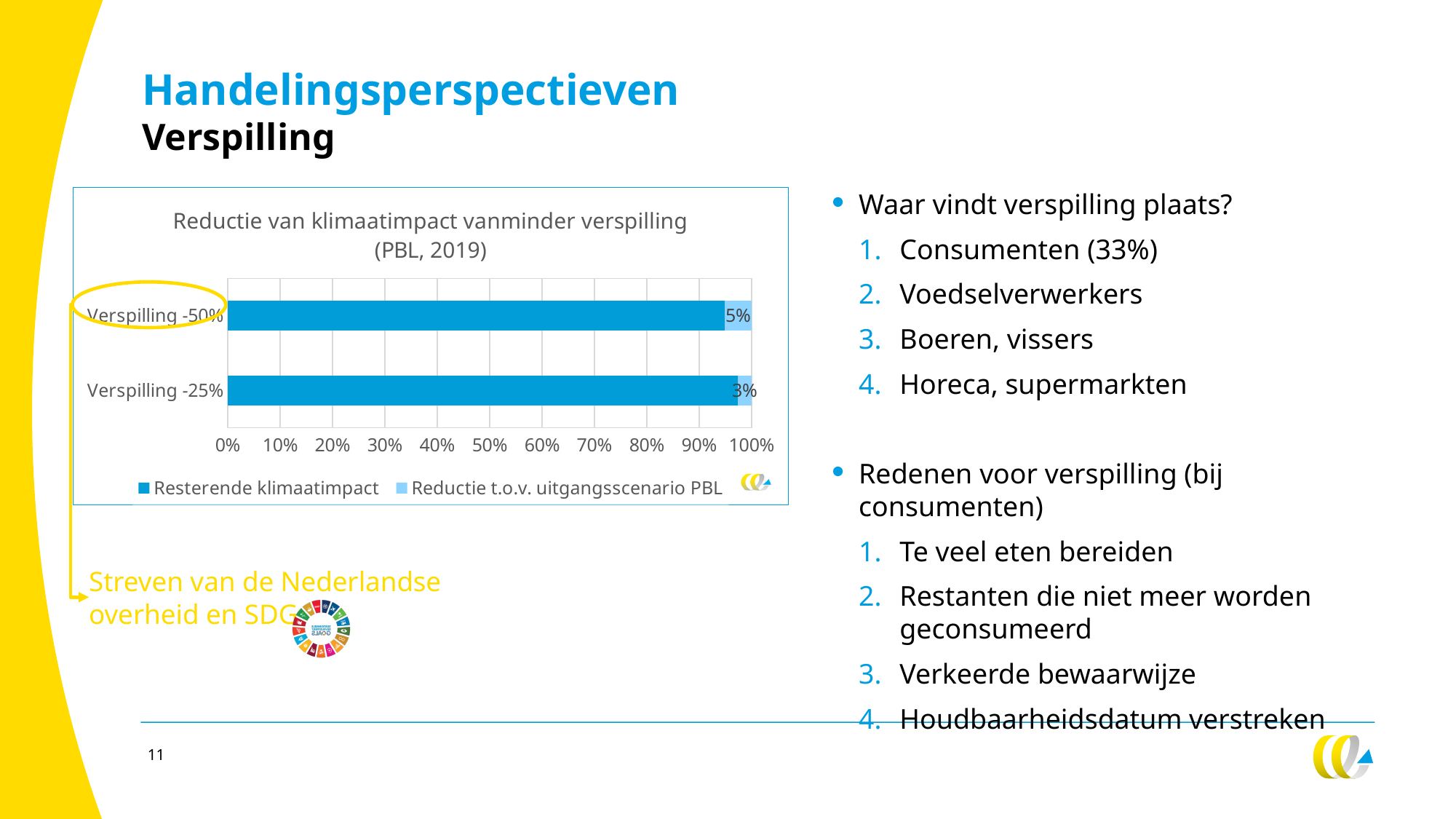
Which category has the highest 'Reductie t.o.v. uitgangsscenario PBL' value? Verspilling -50% Is the 'Resterende klimaatimpact' value for 'Verspilling -25%' greater or less than 80%? greater How many series does the chart legend list? 2 What is the value of 'Reductie t.o.v. uitgangsscenario PBL' for 'Verspilling -25%'? 3% What kind of chart is shown on the slide? Bar chart What is the value of 'Reductie t.o.v. uitgangsscenario PBL' for 'Verspilling -50%'? 5% How many categories are shown on the chart? 2 Which has a larger 'Reductie t.o.v. uitgangsscenario PBL' value: 'Verspilling -50%' or 'Verspilling -25%'? Verspilling -50% Is the 'Resterende klimaatimpact' value for 'Verspilling -50%' greater or less than 90%? greater What is the difference between the 'Reductie t.o.v. uitgangsscenario PBL' values for 'Verspilling -50%' and 'Verspilling -25%'? 2% Which category has the lowest 'Reductie t.o.v. uitgangsscenario PBL' value? Verspilling -25% What is the title of the chart? Reductie van klimaatimpact vanminder verspilling (PBL, 2019)